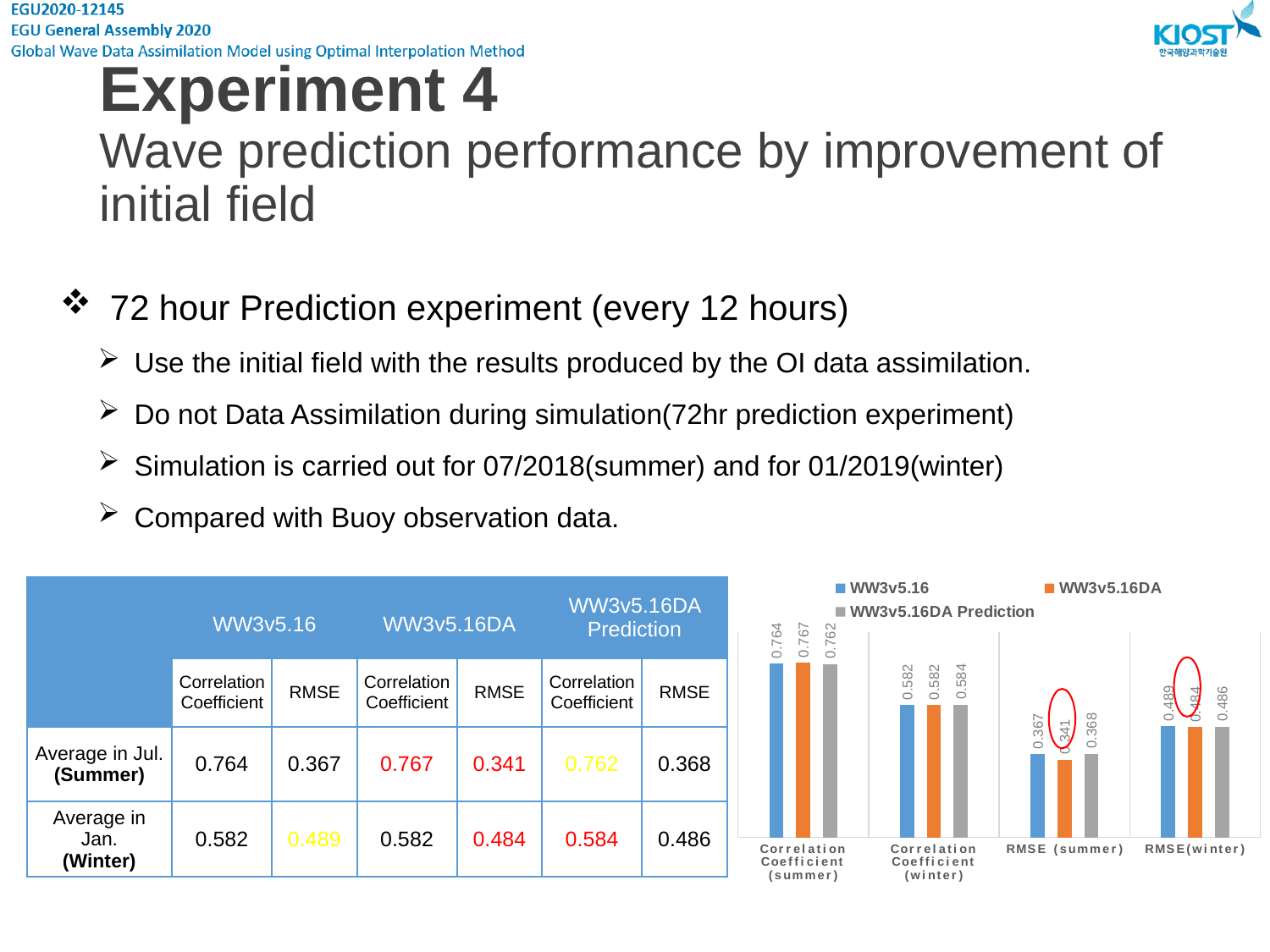
Which series has the lowest value for RMSE (summer)? WW3v5.16DA What is the value of WW3v5.16DA Prediction for Correlation Coefficient (winter)? 0.584 How many series does the chart legend list? 3 What is the difference between the WW3v5.16 and WW3v5.16DA values for RMSE (summer)? 0.026 Which series has the highest value for Correlation Coefficient (summer)? WW3v5.16DA What is the value of WW3v5.16DA for Correlation Coefficient (summer)? 0.767 What is the value of WW3v5.16DA Prediction for RMSE(winter)? 0.486 Which series is shown in orange in the chart? WW3v5.16DA Which is larger: the WW3v5.16 value for Correlation Coefficient (summer) or the WW3v5.16 value for Correlation Coefficient (winter)? Correlation Coefficient (summer) What kind of chart is shown on the right of the slide? bar chart What is the value of WW3v5.16 for RMSE (summer)? 0.367 How many category groups are shown along the x axis of the chart? 4